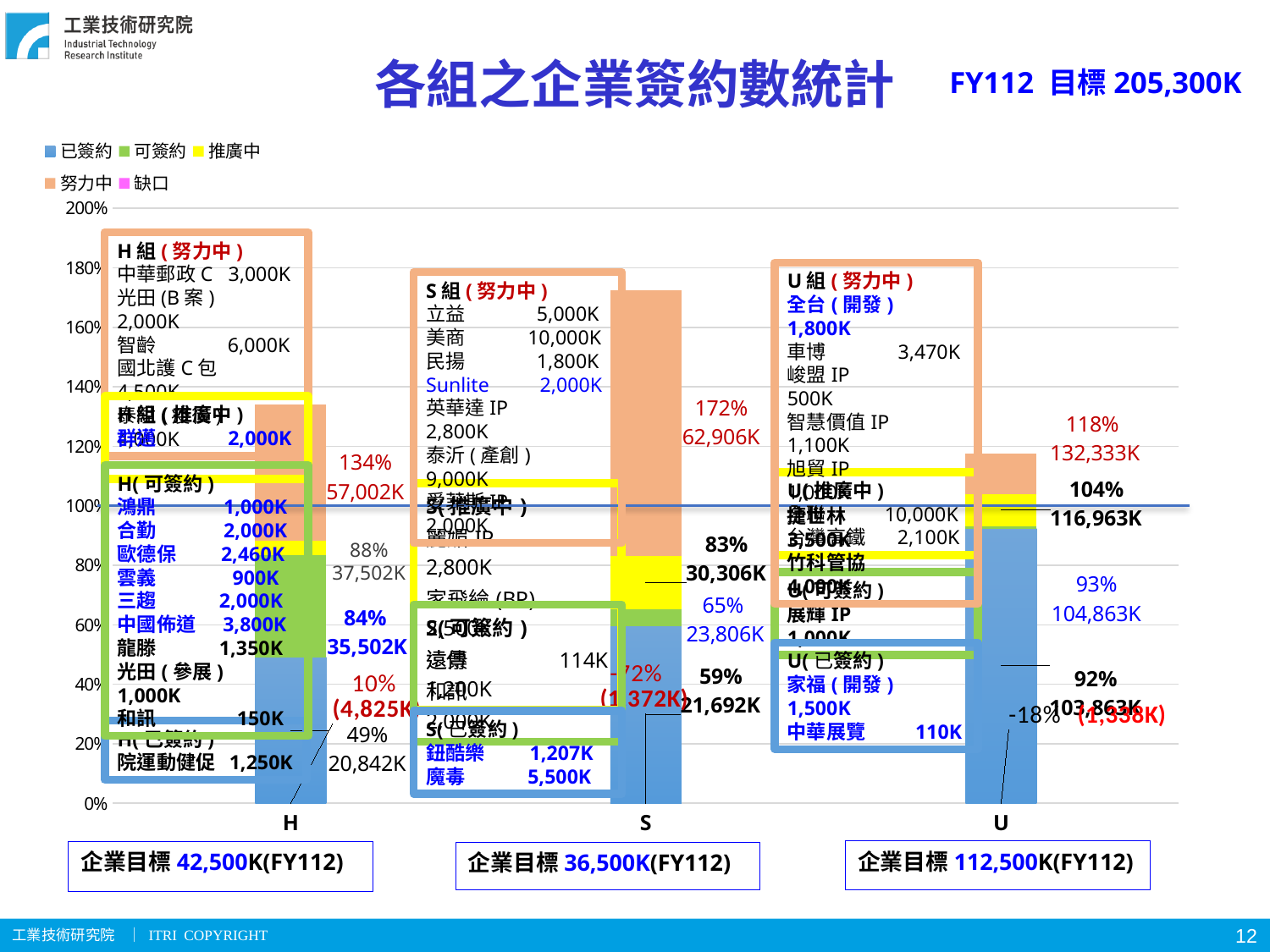
Which category has the shortest stacked bar? U Is the top of the U bar greater or less than 140%? less What percentage label is shown at the top of the S bar? 172% How many series does the chart legend list? 5 What percentage is shown for the 已簽約 level of the U bar? 92% What value in K is shown at the top of the H bar? 57,002K What is the difference between the top percentage of the S bar (172%) and the top percentage of the H bar (134%)? 38% What kind of chart is shown on the slide? bar chart What is the FY112 target shown next to the chart title? 205,300K How many categories are shown on the x axis of the chart? 3 Which is larger, the 已簽約 percentage for S (59%) or for H (49%)? S Which category has the tallest stacked bar? S